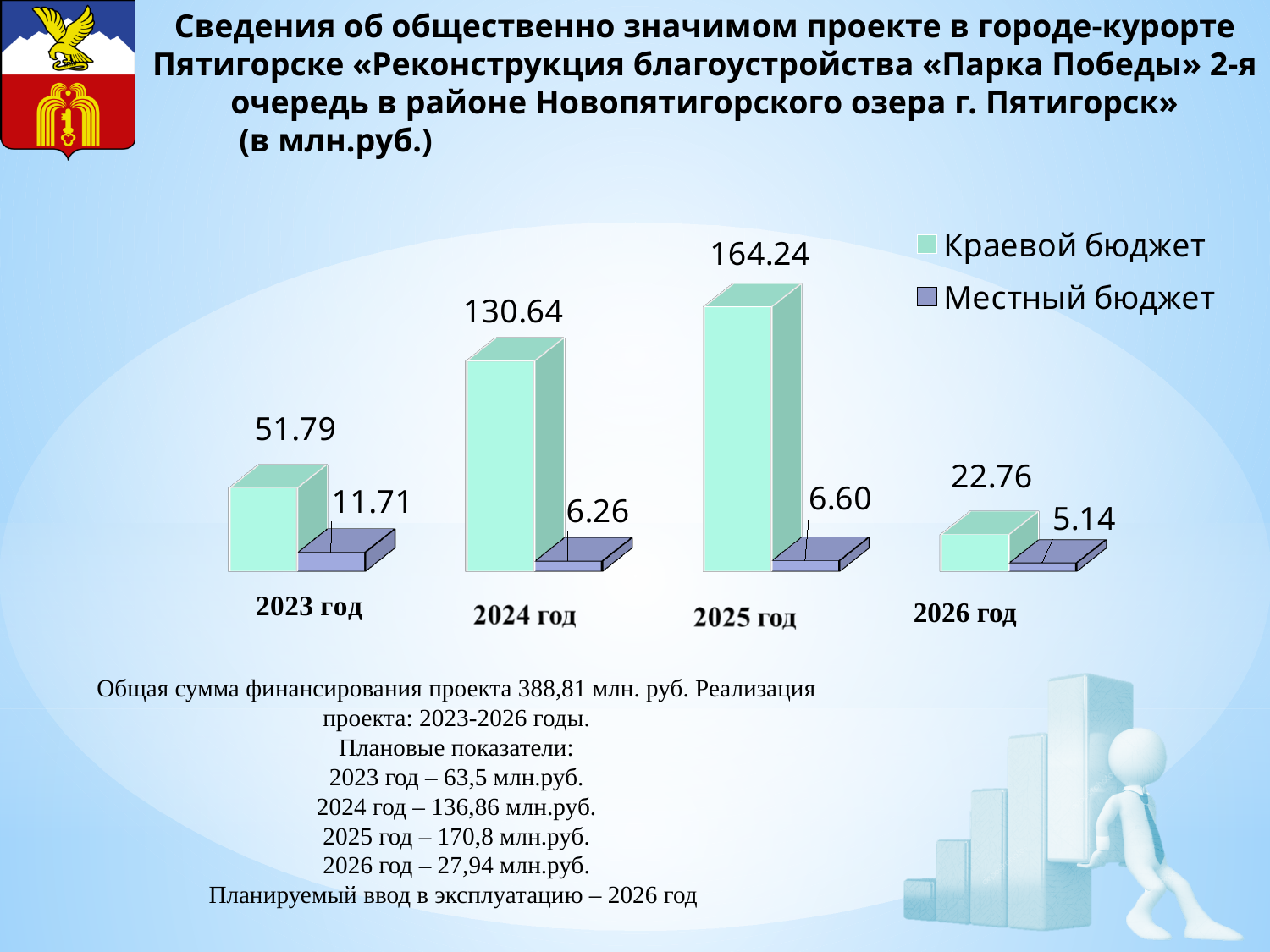
Which is larger: the Местный бюджет value for 2023 год or for 2024 год? 2023 год In which year is the Местный бюджет value lowest? 2026 год What kind of chart is shown on the slide? Bar chart How many series does the legend list? 2 What is the combined value of Краевой бюджет and Местный бюджет for 2023 год? 63.50 What is the value for Краевой бюджет in 2024 год? 130.64 What is the value for Местный бюджет in 2025 год? 6.60 What is the difference between the Краевой бюджет values for 2025 год and 2024 год? 33.60 How many years are shown on the x axis? 4 What is the value for Краевой бюджет in 2026 год? 22.76 What is the value for Местный бюджет in 2023 год? 11.71 In which year is the Краевой бюджет value highest? 2025 год